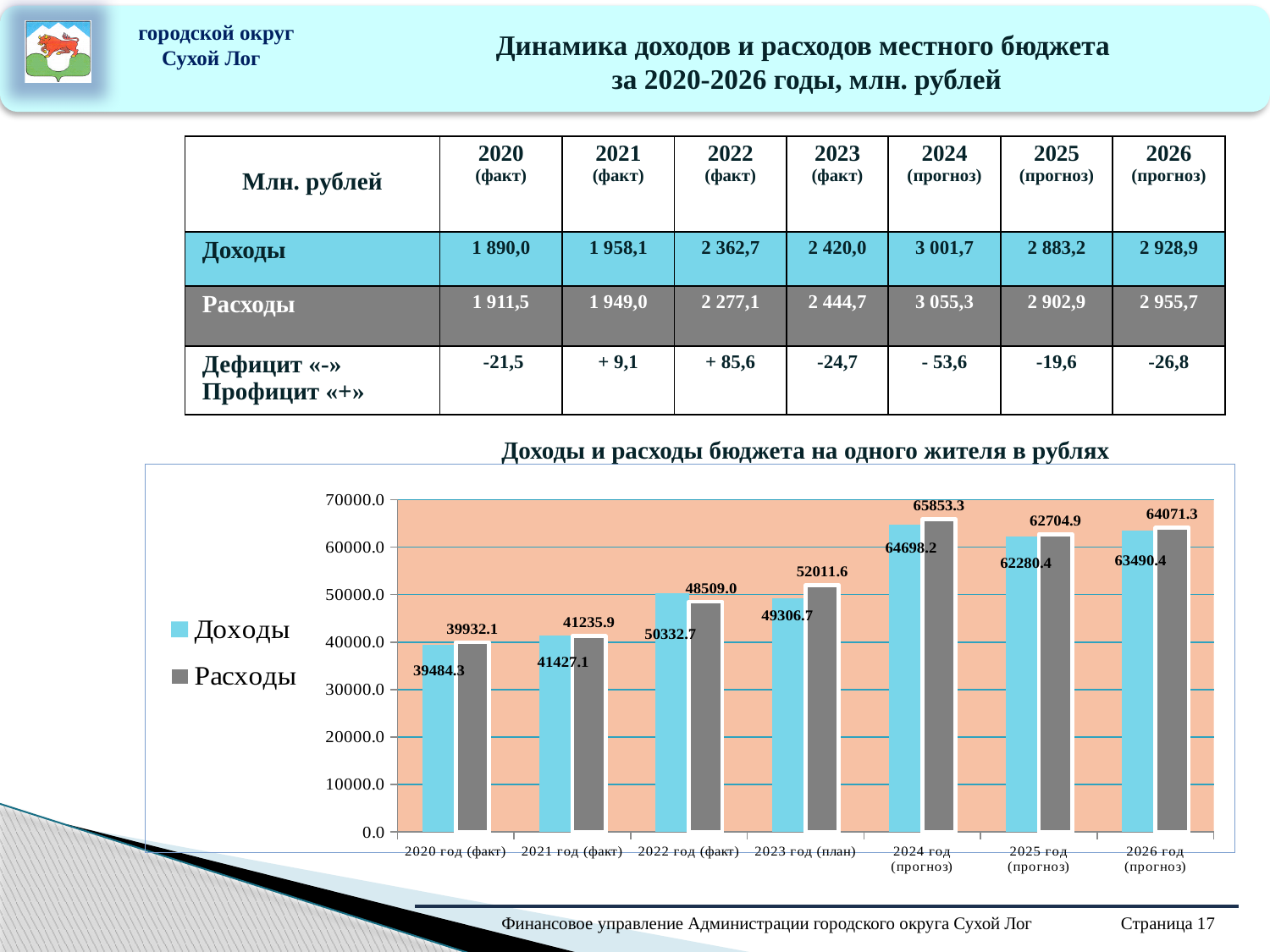
What kind of chart is shown on the slide? bar chart In which year is the Доходы value lowest? 2020 год (факт) What is the value of Расходы for 2024 год (прогноз)? 65853.3 How many year categories are shown on the x axis? 7 How many series does the legend list? 2 For 2022 год (факт), which is larger: Доходы or Расходы? Доходы Is the value of Доходы for 2021 год (факт) greater or less than 40000.0? greater In which year is the Расходы value highest? 2024 год (прогноз) What is the difference between Расходы and Доходы for 2024 год (прогноз)? 1155.1 What is the value of Доходы for 2020 год (факт)? 39484.3 What is the difference between Расходы and Доходы for 2023 год (план)? 2704.9 What is the value of Доходы for 2026 год (прогноз)? 63490.4